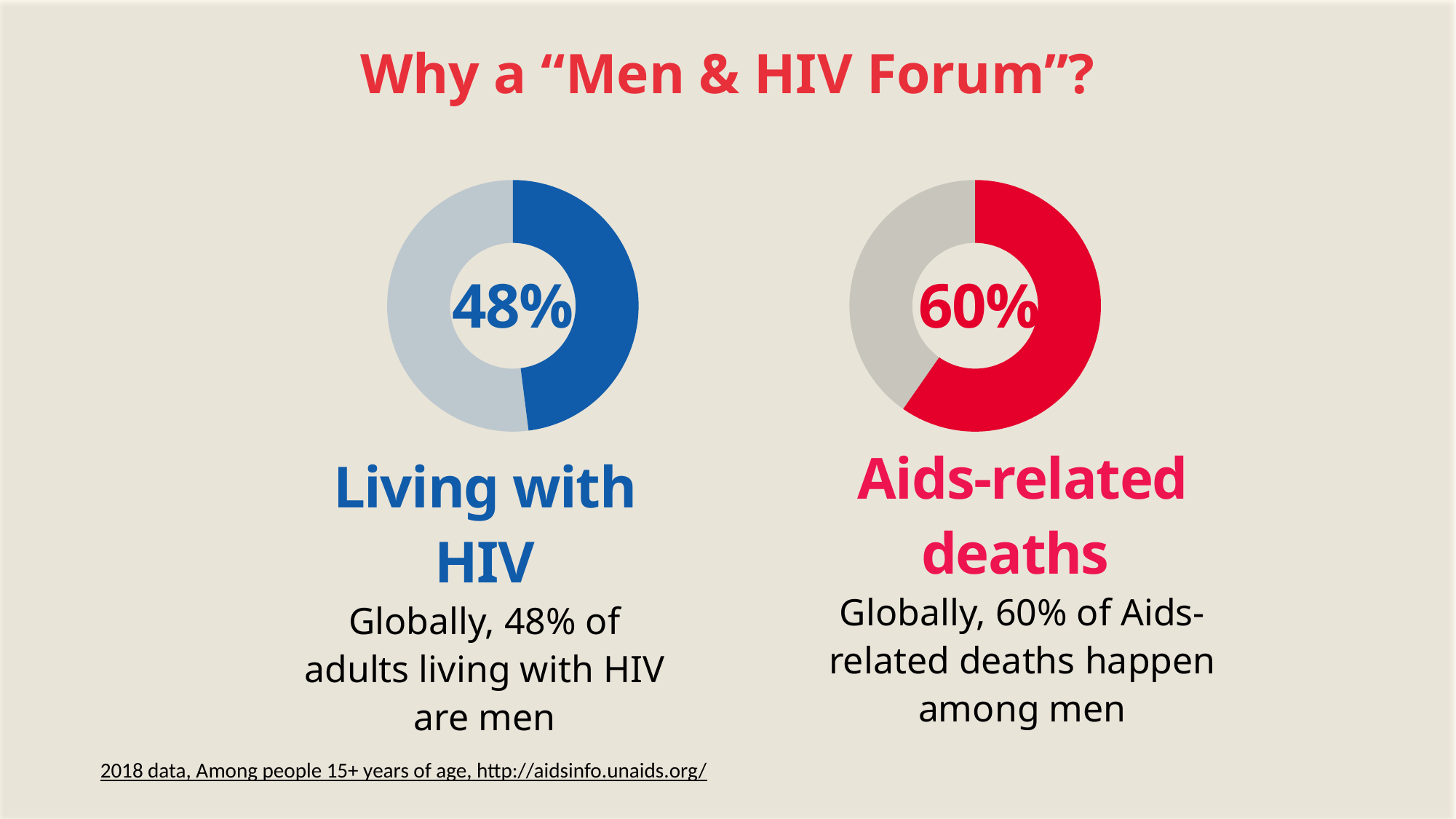
In the 'Living with HIV' chart, is the men's share greater or less than 50%? less What kind of chart is the 'Aids-related deaths' chart? Doughnut chart What is the difference between the men's share in the 'Aids-related deaths' chart and the 'Living with HIV' chart? 12% In the 'Aids-related deaths' chart, is the men's share greater or less than 50%? greater In the 'Living with HIV' chart, what percentage of adults living with HIV are men? 48% What is the title of the slide? Why a "Men & HIV Forum"? In the 'Aids-related deaths' chart, what percentage of Aids-related deaths happen among men? 60% What colour is the highlighted segment in the 'Aids-related deaths' chart? Red How many doughnut charts are shown on the slide? 2 Which chart shows the larger share for men, 'Living with HIV' or 'Aids-related deaths'? Aids-related deaths In the 'Living with HIV' chart, what share of the doughnut is not men? 52% What kind of chart is the 'Living with HIV' chart? Doughnut chart